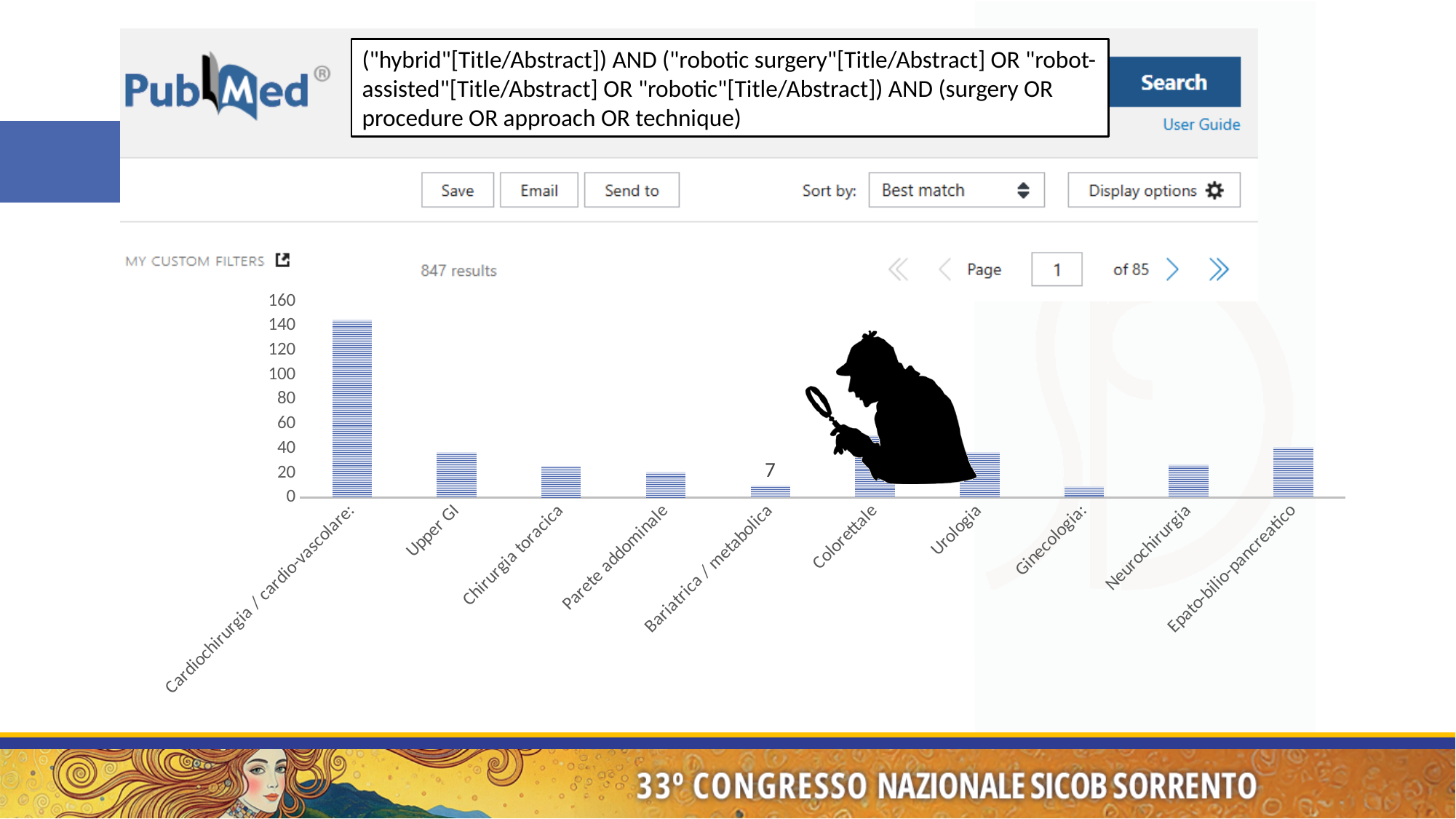
What is the highest tick value shown on the y axis? 160 How many categories are shown on the x axis? 10 Which is larger, the value for Epato-bilio-pancreatico or the value for Parete addominale? Epato-bilio-pancreatico What kind of chart is shown on the slide? Bar chart What value is labelled on the bar for Bariatrica / metabolica? 7 Is the value for Parete addominale greater or less than 40? less How many results does the PubMed search shown above the chart report? 847 results Is the value for Upper GI greater or less than 60? less Which is larger, the value for Cardiochirurgia / cardio-vascolare or the value for Upper GI? Cardiochirurgia / cardio-vascolare Is the value for Cardiochirurgia / cardio-vascolare greater or less than 100? greater Which category has the highest bar? Cardiochirurgia / cardio-vascolare